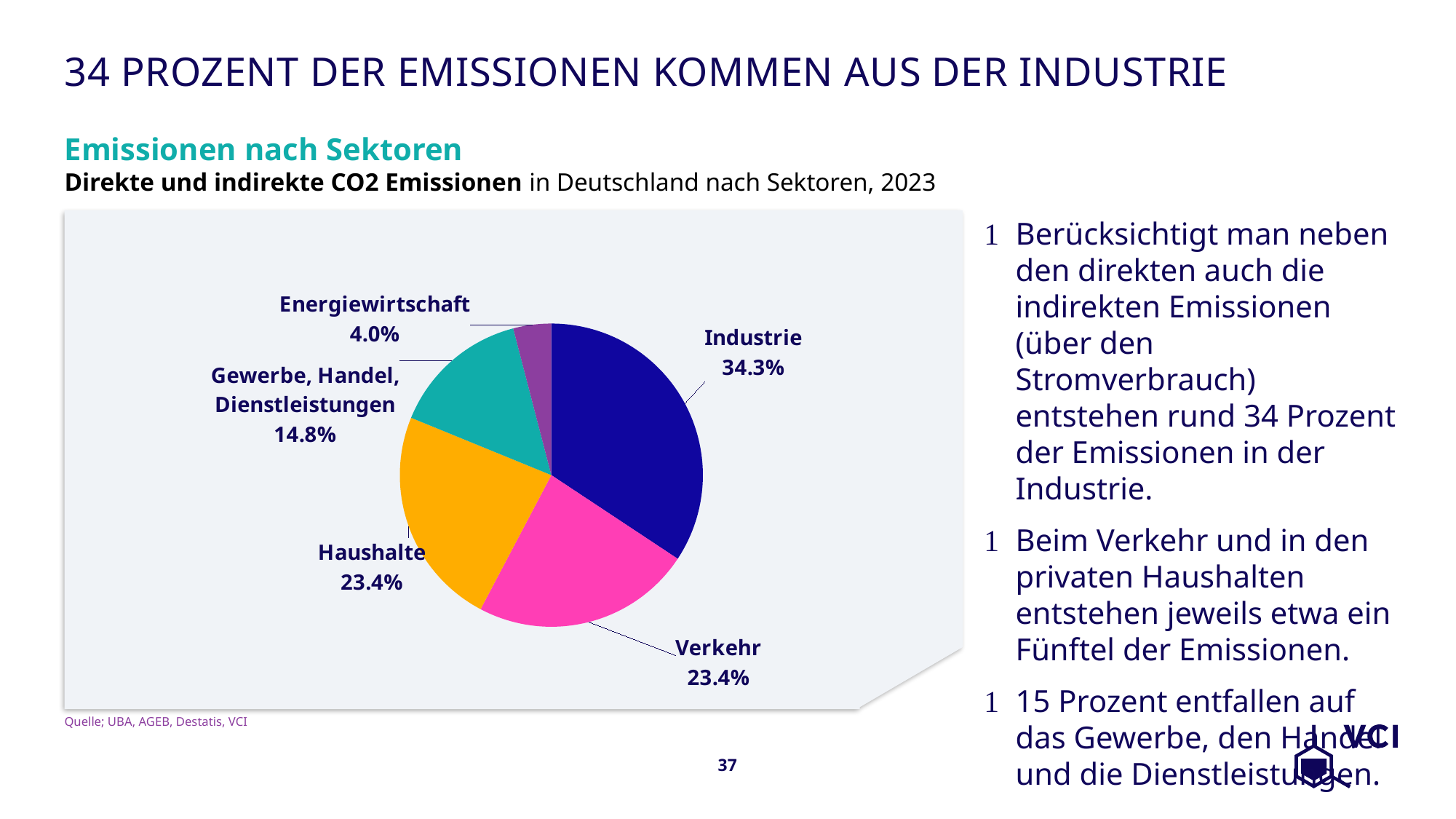
Which sector has the largest share of emissions in the pie chart? Industrie What is the title of the chart? Emissionen nach Sektoren What share of emissions is attributed to Energiewirtschaft? 4.0% What is the difference in percentage points between Gewerbe, Handel, Dienstleistungen and Energiewirtschaft? 10.8 How many sectors are shown in the pie chart? 5 What type of chart is shown on the slide? Pie chart Which has a larger share, Haushalte or Gewerbe, Handel, Dienstleistungen? Haushalte What is the difference in percentage points between Industrie and Verkehr? 10.9 What percentage is shown for Gewerbe, Handel, Dienstleistungen? 14.8% What share of emissions does the Industrie slice represent? 34.3% What percentage is shown for Haushalte? 23.4% Which sector has the smallest share of emissions in the pie chart? Energiewirtschaft